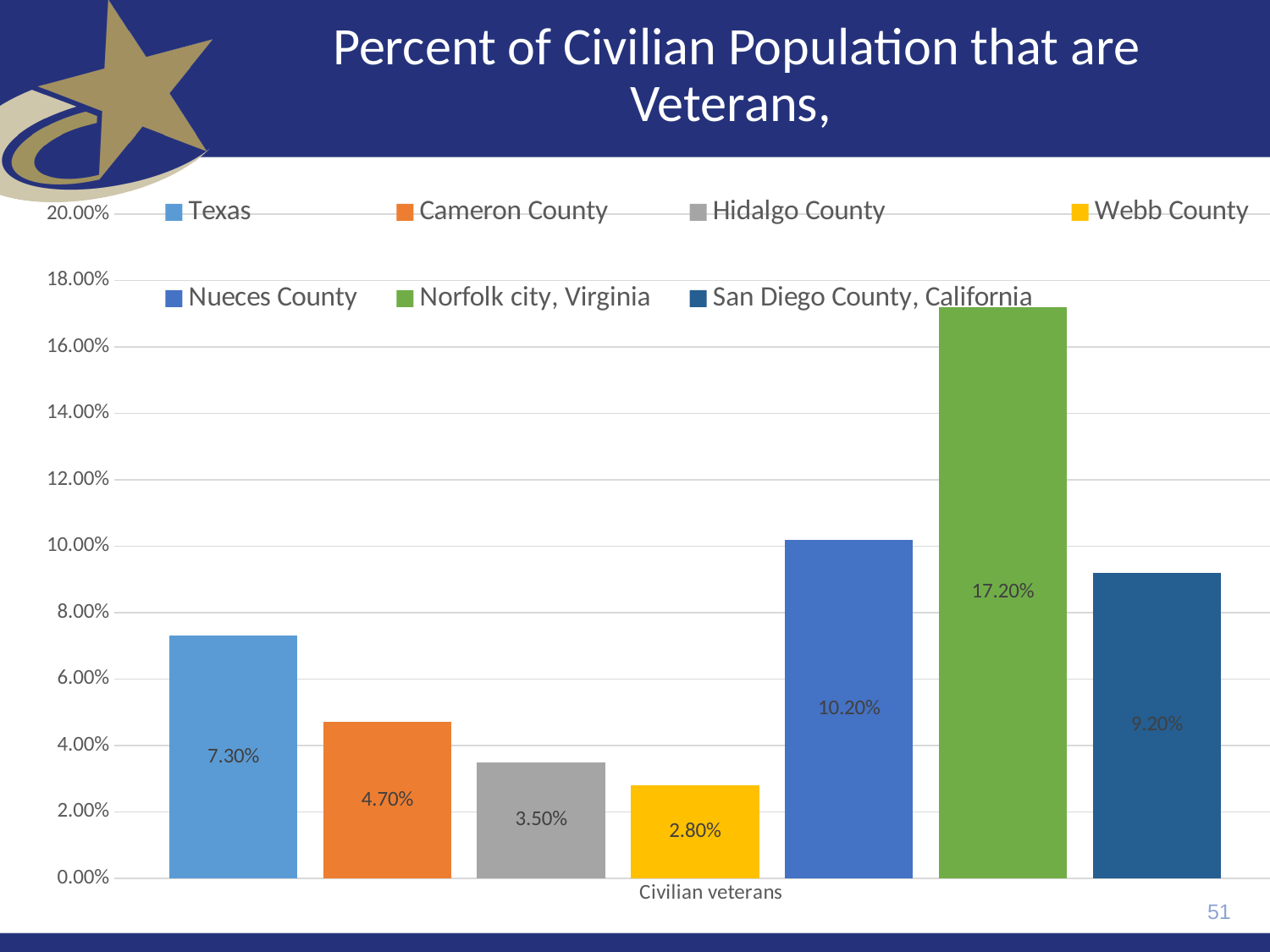
How many series does the legend list? 7 What is the value for Norfolk city, Virginia? 17.20% What is the difference between the values for Texas and Hidalgo County? 3.80% Which series has the highest percent of civilian population that are veterans? Norfolk city, Virginia What is the value for Texas? 7.30% What is the difference between the values for Norfolk city, Virginia and Nueces County? 7.00% Which is larger, the value for Cameron County or the value for San Diego County, California? San Diego County, California What kind of chart is shown on the slide? bar chart What is the label on the x axis of the chart? Civilian veterans Is the value for Nueces County greater or less than 8.00%? greater What is the value for Webb County? 2.80% Which series has the lowest percent of civilian population that are veterans? Webb County